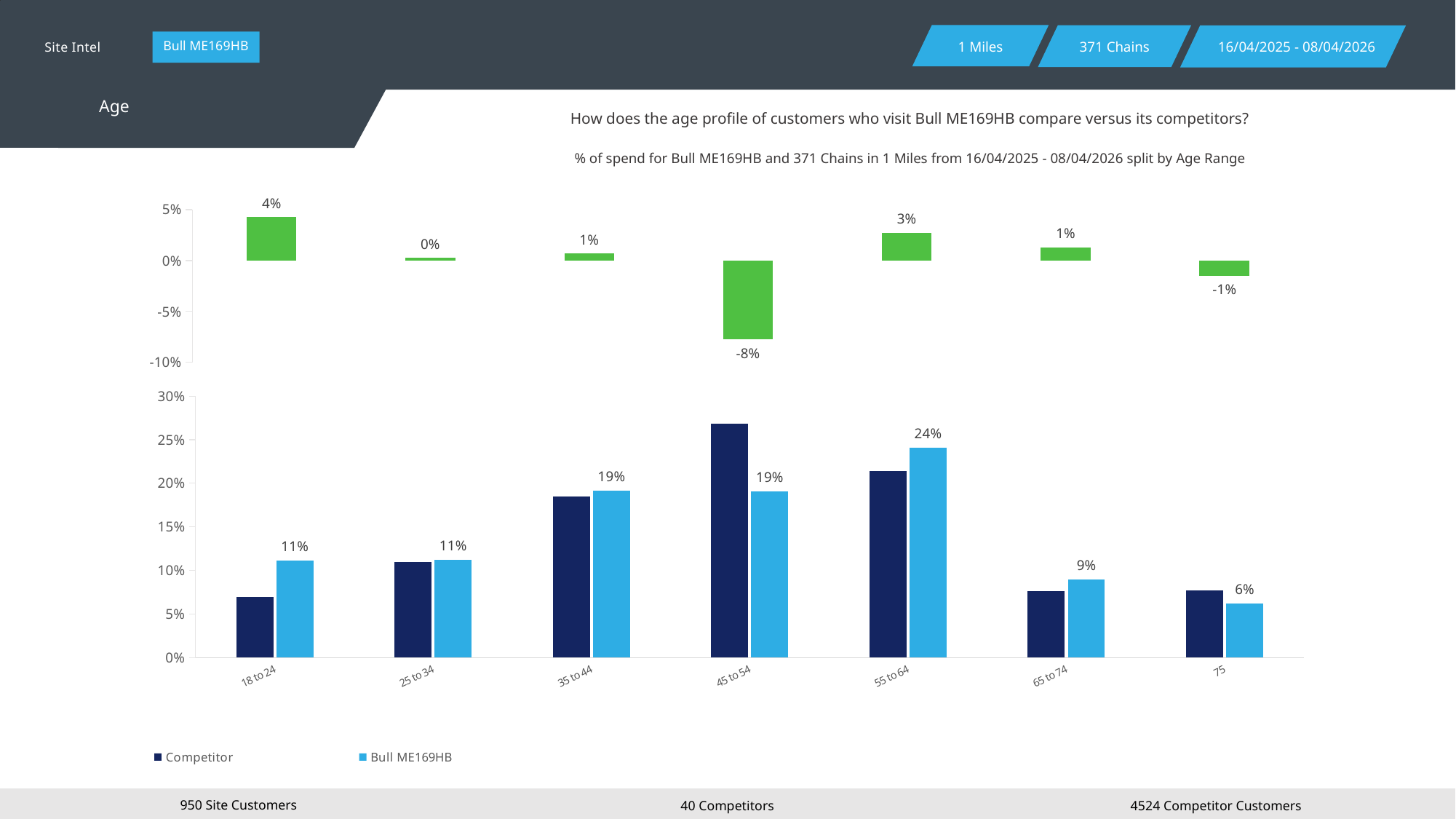
In the bottom bar chart, which age range has the highest value for Bull ME169HB? 55 to 64 In the top chart, what is the value shown for the 45 to 54 age range? -8% In the bottom bar chart, what is the value for Bull ME169HB in the 75 age range? 6% How many age range categories are shown on the x axis of the bottom chart? 7 In the bottom bar chart, is the Competitor value for 45 to 54 greater or less than 25%? greater In the bottom bar chart, which is larger for the 45 to 54 age range, the Competitor bar or the Bull ME169HB bar? Competitor How many series does the legend of the bottom bar chart list? 2 In the bottom bar chart, what is the value for Bull ME169HB in the 55 to 64 age range? 24% In the bottom bar chart, is the Competitor value for 18 to 24 greater or less than 10%? less In the bottom bar chart, what is the difference between the Bull ME169HB values for 55 to 64 and 65 to 74? 15% In the top chart, which age range has the highest value? 18 to 24 In the bottom bar chart, which age range has the lowest value for Bull ME169HB? 75